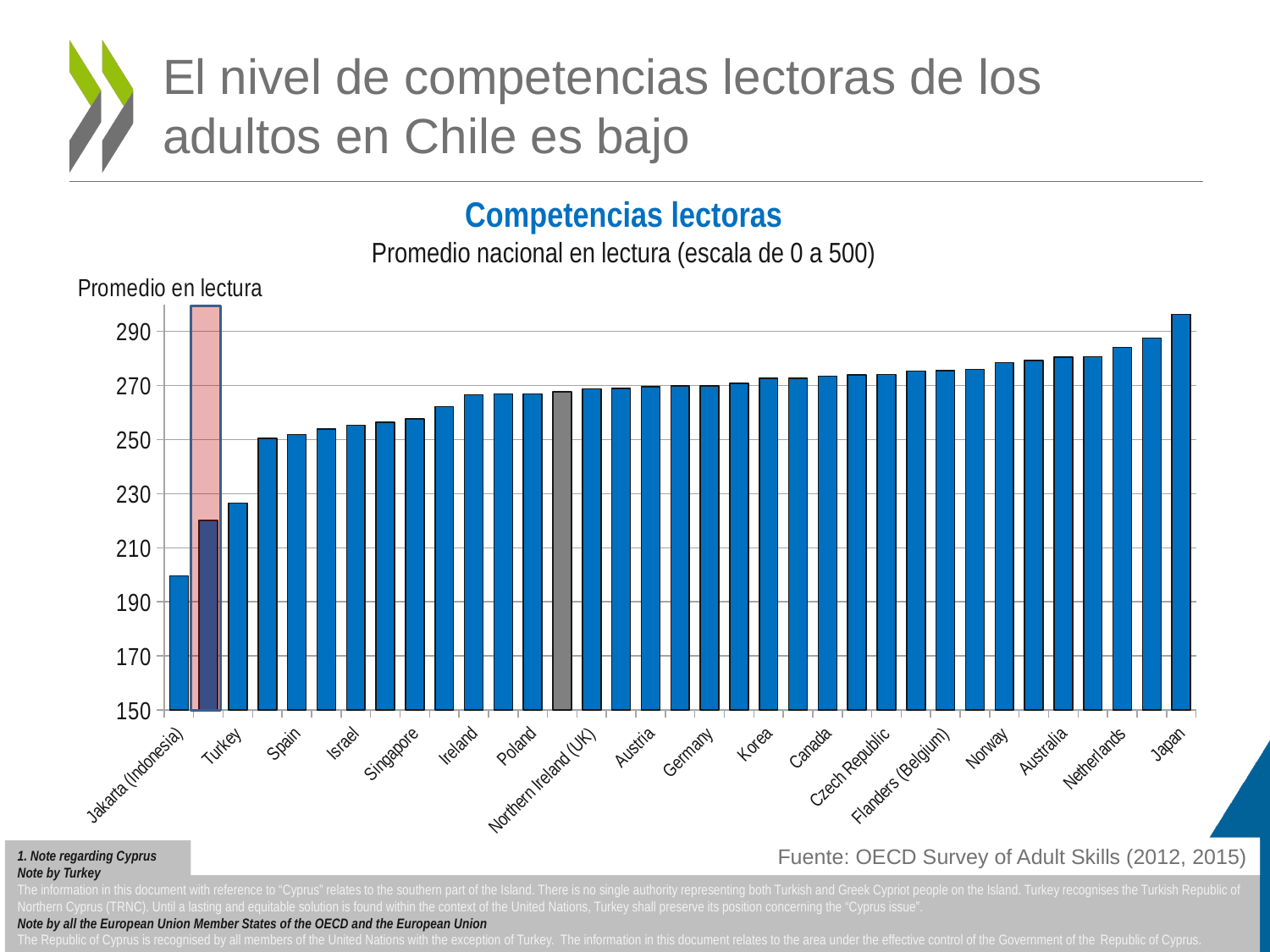
Do the bar values generally rise or fall from left to right along the x axis? rise Which has a higher reading average, Turkey or Spain? Spain Which country has the highest reading average in the chart? Japan What is the title of the chart? Competencias lectoras Is the value for Jakarta (Indonesia) greater or less than 210? less Is the value for Singapore greater or less than 250? greater Is the value for Norway greater or less than 270? greater What kind of chart is shown on the slide? bar chart Which labelled category has the lowest reading average in the chart? Jakarta (Indonesia)